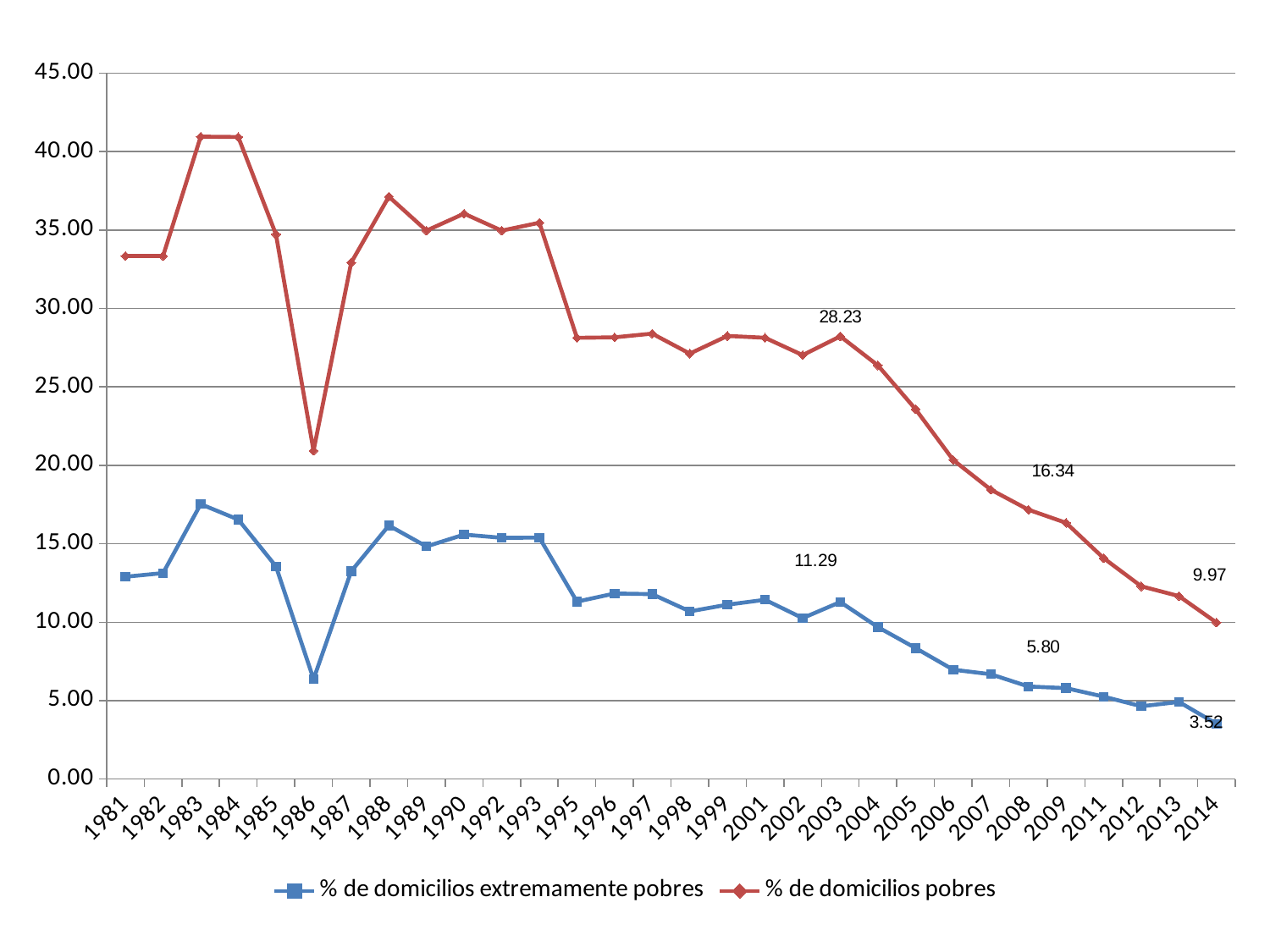
What kind of chart is shown on the slide? line chart In which year is % de domicilios extremamente pobres highest? 1983 What is the value of % de domicilios extremamente pobres in 2003? 11.29 By how much did % de domicilios pobres fall between 2003 and 2014? 18.26 What is the value of % de domicilios pobres in 2014? 9.97 How many series does the legend list? 2 What is the value of % de domicilios extremamente pobres in 2014? 3.52 What is the value of % de domicilios pobres in 2003? 28.23 In 2014, what is the difference between % de domicilios pobres and % de domicilios extremamente pobres? 6.45 Is the value of % de domicilios pobres in 1986 greater or less than 25.00? less